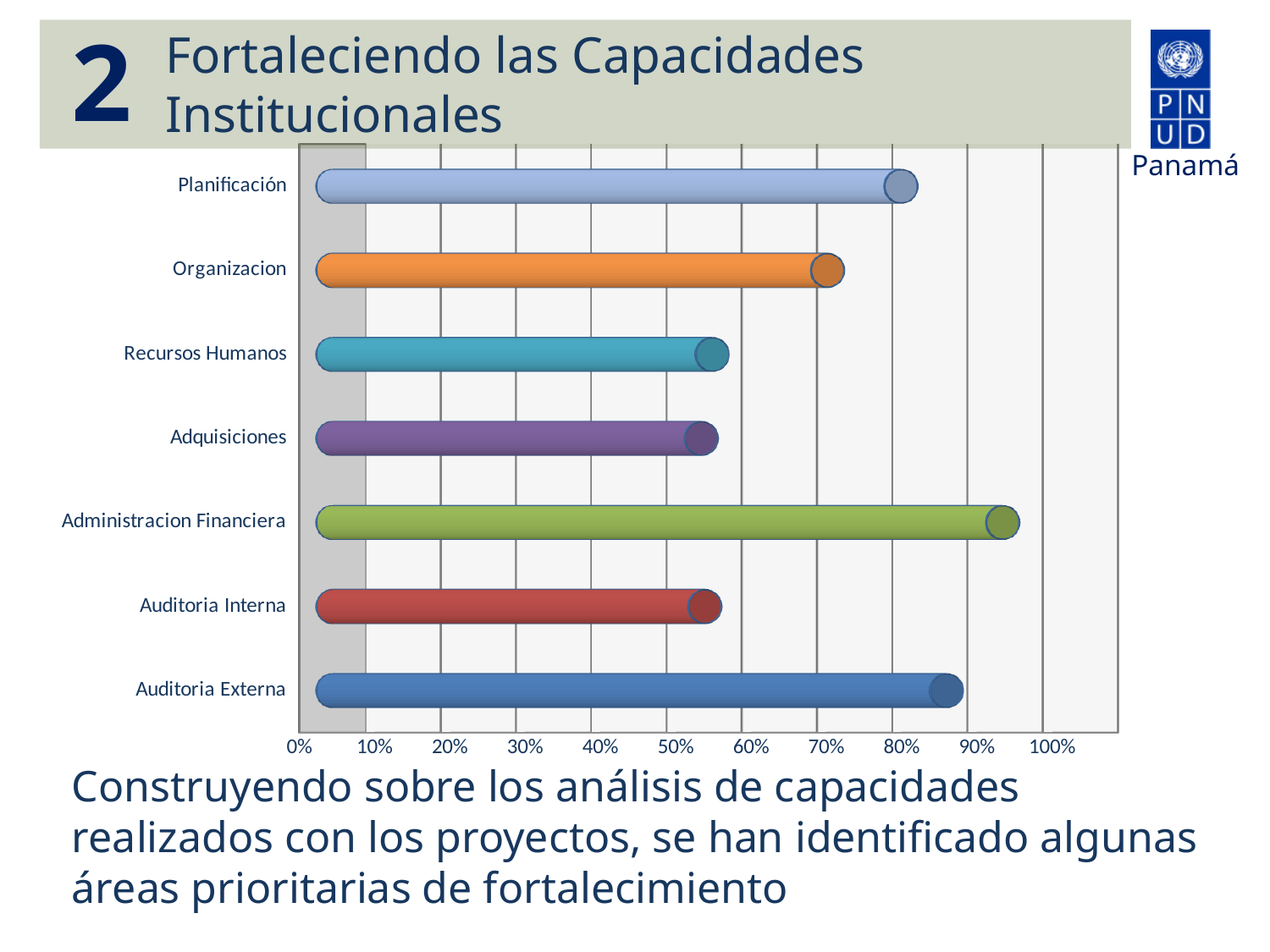
What is the title of the slide containing the chart? Fortaleciendo las Capacidades Institucionales How many categories are plotted in the chart? 7 Which has the larger value, Planificación or Organizacion? Planificación Is the value for Auditoria Externa greater or less than 80%? greater Is the value for Adquisiciones greater or less than 60%? less Is the value for Planificación greater or less than 70%? greater Which has the larger value, Auditoria Externa or Auditoria Interna? Auditoria Externa Which category has the highest value in the chart? Administracion Financiera What kind of chart is shown on the slide? bar chart What is the highest tick label shown on the horizontal axis of the chart? 100%